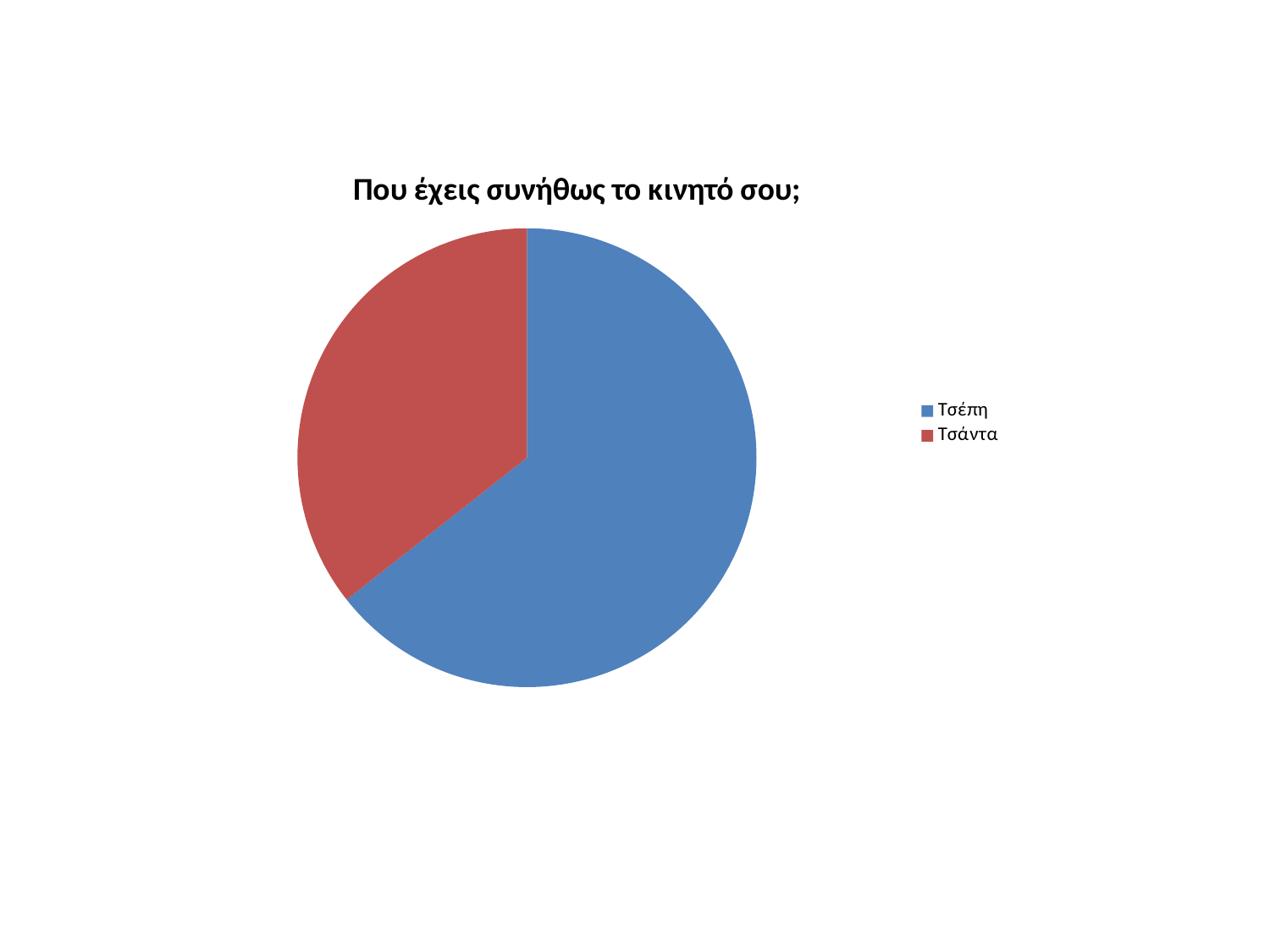
Which category has the smallest slice of the pie? Τσάντα How many entries does the legend list? 2 Which category has the largest slice of the pie? Τσέπη What kind of chart is shown on the slide? pie chart How many slices does the pie chart have? 2 Which slice is larger, Τσέπη or Τσάντα? Τσέπη What is the title of the chart? Που έχεις συνήθως το κινητό σου; What colour is the slice for Τσάντα? red